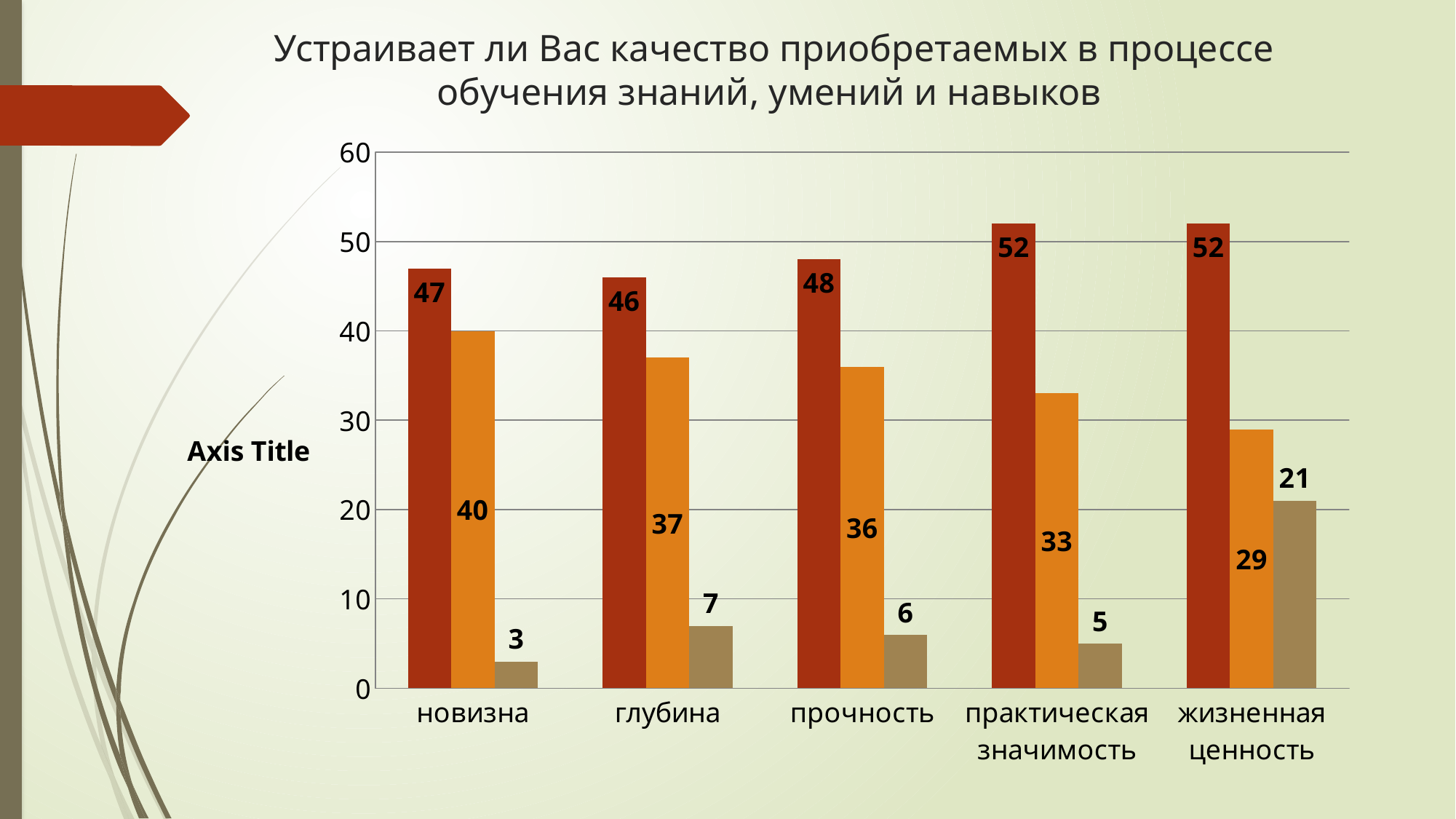
Which category has the lowest value for the orange bars? жизненная ценность What is the difference between the dark red bar and the orange bar for 'практическая значимость'? 19 What is the value of the orange bar for 'глубина'? 37 What type of chart is shown on the slide? bar chart Do the values of the orange bars rise or fall from left to right across the categories? fall Which category has the highest value for the tan bars? жизненная ценность Which category has the lowest value for the tan bars? новизна Which is larger: the orange bar for 'новизна' or the orange bar for 'прочность'? новизна What is the value of the tan bar for 'жизненная ценность'? 21 How many categories are shown on the x axis of the chart? 5 What is the label shown on the vertical axis of the chart? Axis Title What is the value of the dark red bar for 'прочность'? 48